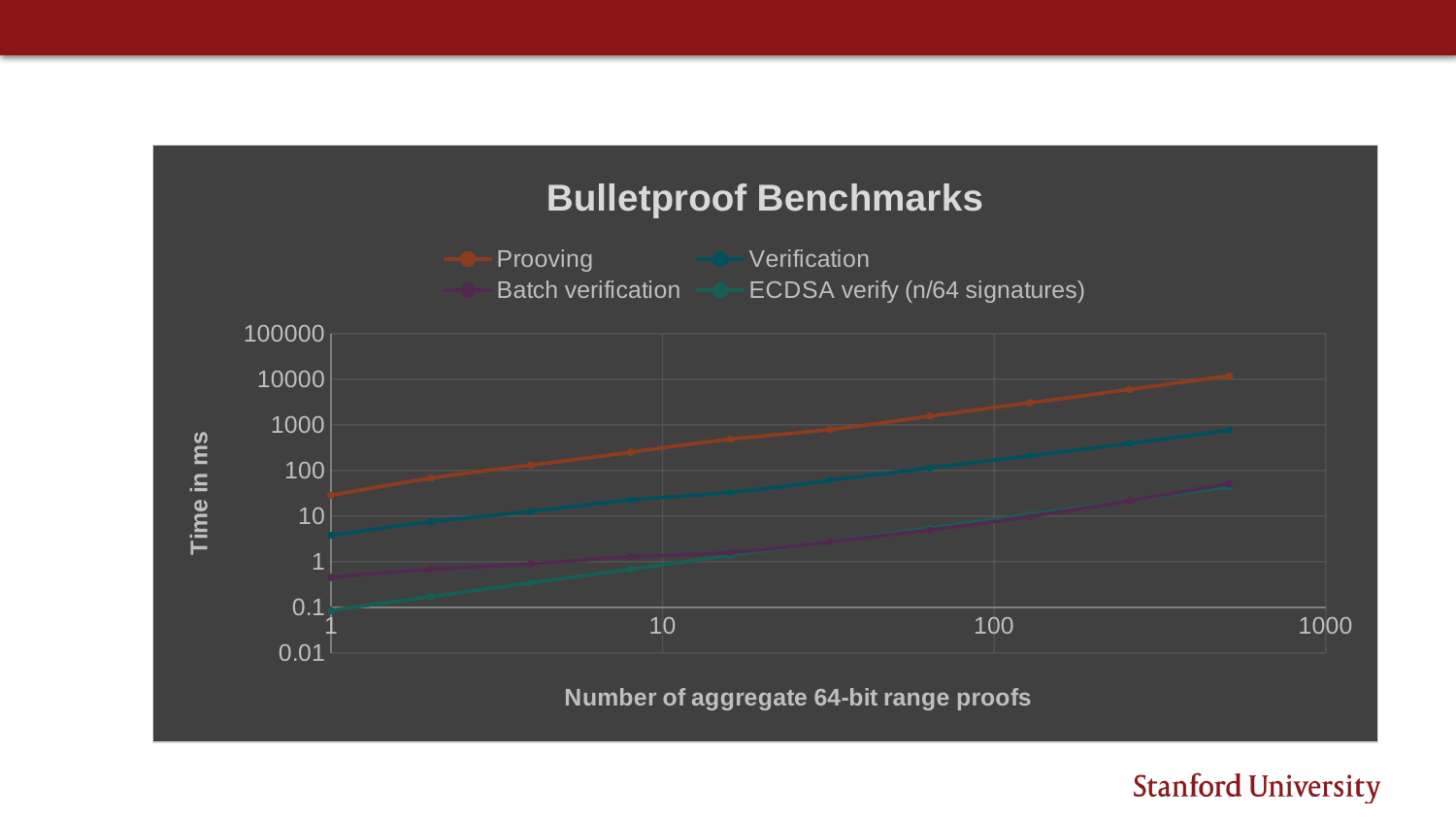
Is the value for Prooving at 100 aggregate range proofs greater or less than 1000? greater Is the value for Verification at 1 aggregate range proof greater or less than 10? less Does the Prooving series rise or fall as the number of aggregate range proofs increases? rise Which series has the highest values across the whole x axis? Prooving At 1 aggregate range proof, which is larger: Batch verification or ECDSA verify (n/64 signatures)? Batch verification How many series does the legend list? 4 What kind of chart is shown on the slide? line chart What is the title of the chart? Bulletproof Benchmarks What is the label of the y axis? Time in ms Is the value for Prooving at 1 aggregate range proof greater or less than 10? greater At 10 aggregate range proofs, which is larger: Prooving or Verification? Prooving